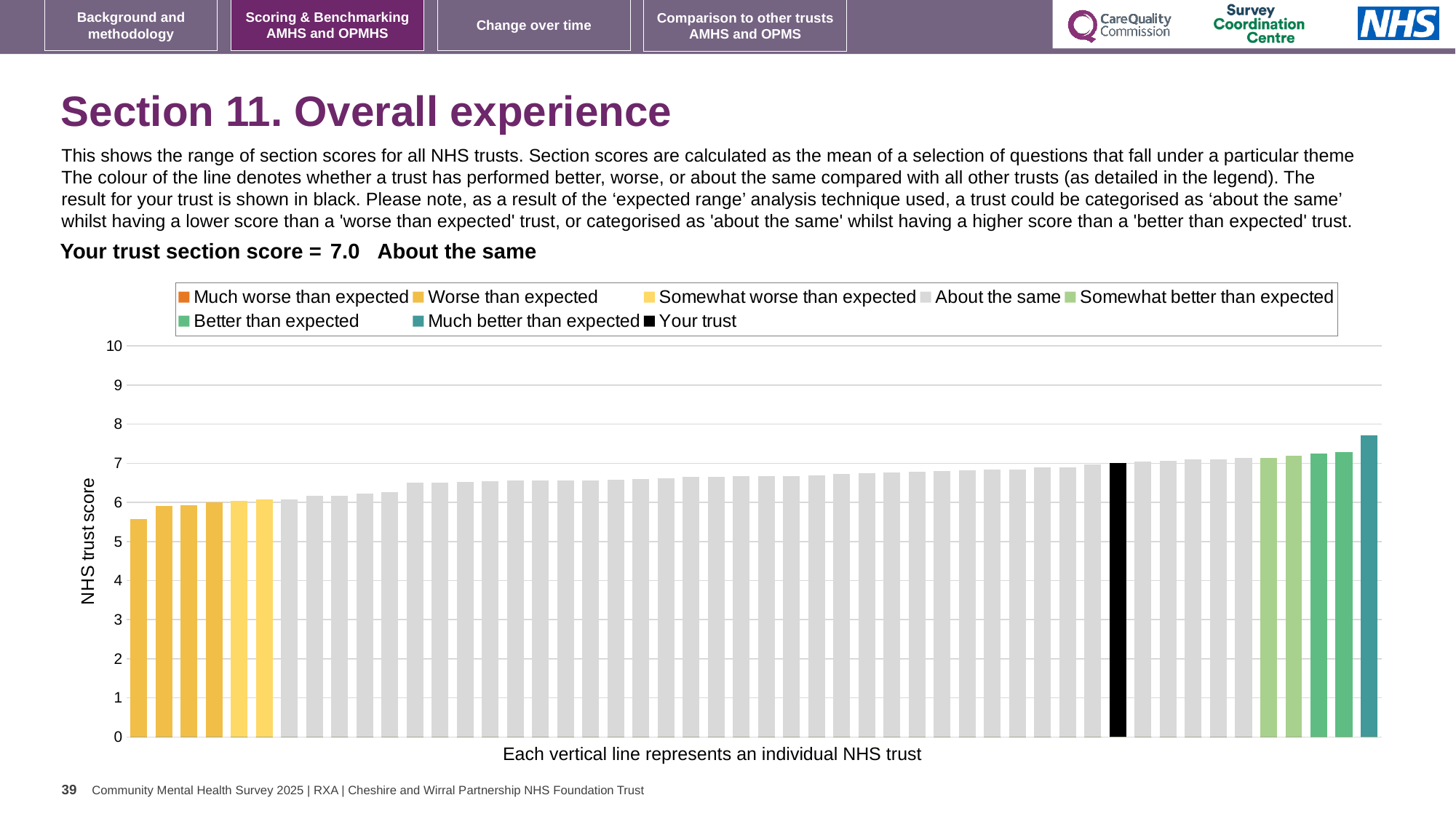
Is the value of the tallest bar greater or less than 8? less What is the label on the y axis of the chart? NHS trust score What is the section score for your trust shown on the slide? 7.0 What does the caption below the x axis say each vertical line represents? an individual NHS trust Is the value of the shortest bar greater or less than 5? greater How many bars are coloured as 'Better than expected'? 2 Which category is your trust placed in for this section? About the same Do the bar values rise or fall from left to right along the x axis? rise What kind of chart is shown on the slide? bar chart How many bars are coloured as 'Much better than expected'? 1 Is the value of the black bar (your trust) greater or less than 5? greater How many entries does the chart legend list? 8